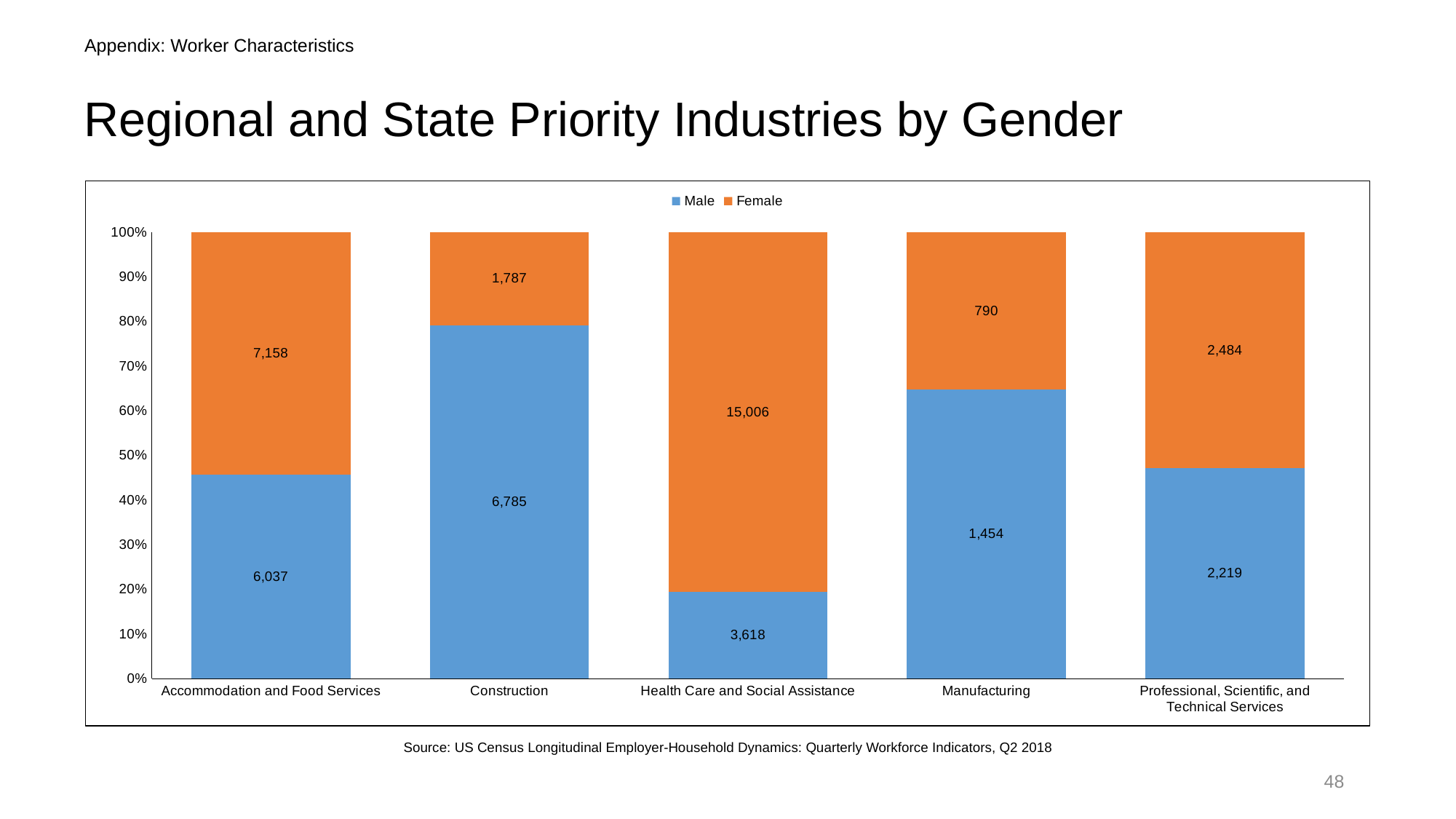
What is the Male value for Construction? 6,785 How many series does the legend list? 2 Which industry has the lowest Male value? Manufacturing What is the total of the Male and Female values for Professional, Scientific, and Technical Services? 4,703 What type of chart is shown on the slide? Stacked bar chart How many industries are shown on the x axis? 5 What is the Female value for Manufacturing? 790 What is the Female value for Health Care and Social Assistance? 15,006 What is the difference between the Female and Male values for Health Care and Social Assistance? 11,388 Which industry has the highest Female value? Health Care and Social Assistance Is the Male share of the Construction bar greater or less than 70%? greater Which is larger for Accommodation and Food Services, the Male value or the Female value? Female